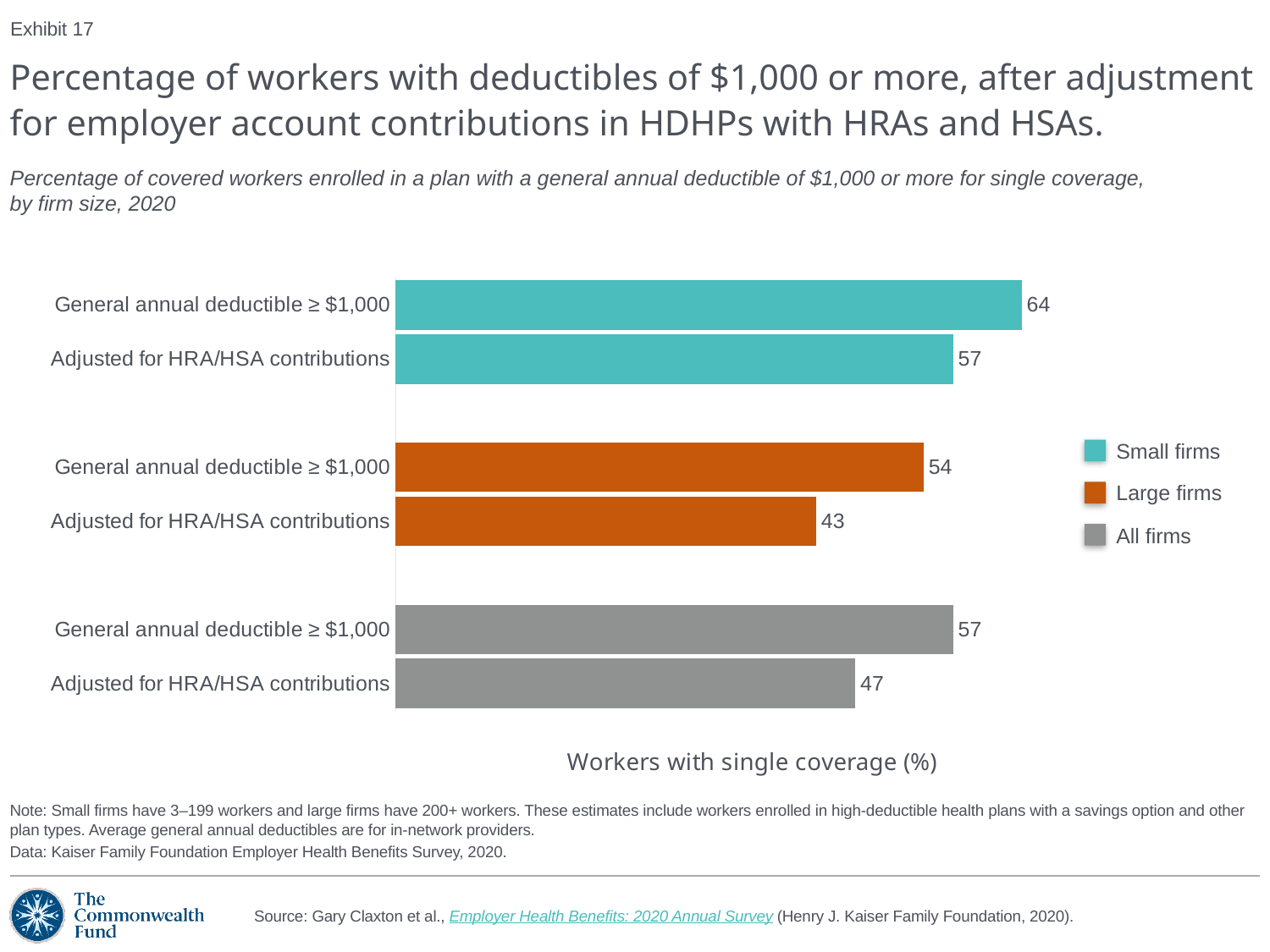
What percentage of workers at small firms have a general annual deductible of $1,000 or more? 64 For large firms, what is the difference between the general annual deductible ≥ $1,000 value and the adjusted for HRA/HSA contributions value? 11 What colour represents large firms in the chart? Orange Which bar has the lowest value on the chart? Large firms, Adjusted for HRA/HSA contributions For all firms, what is the difference between the general annual deductible ≥ $1,000 value and the adjusted value? 10 Which bar has the highest value on the chart? Small firms, General annual deductible ≥ $1,000 What is the value for small firms after adjusting for HRA/HSA contributions? 57 What kind of chart is shown on the slide? Bar chart What is the value for all firms with a general annual deductible of $1,000 or more? 57 Which is larger: the adjusted for HRA/HSA contributions value for small firms or for all firms? Small firms How many series does the legend list? 3 What is the value for large firms after adjusting for HRA/HSA contributions? 43